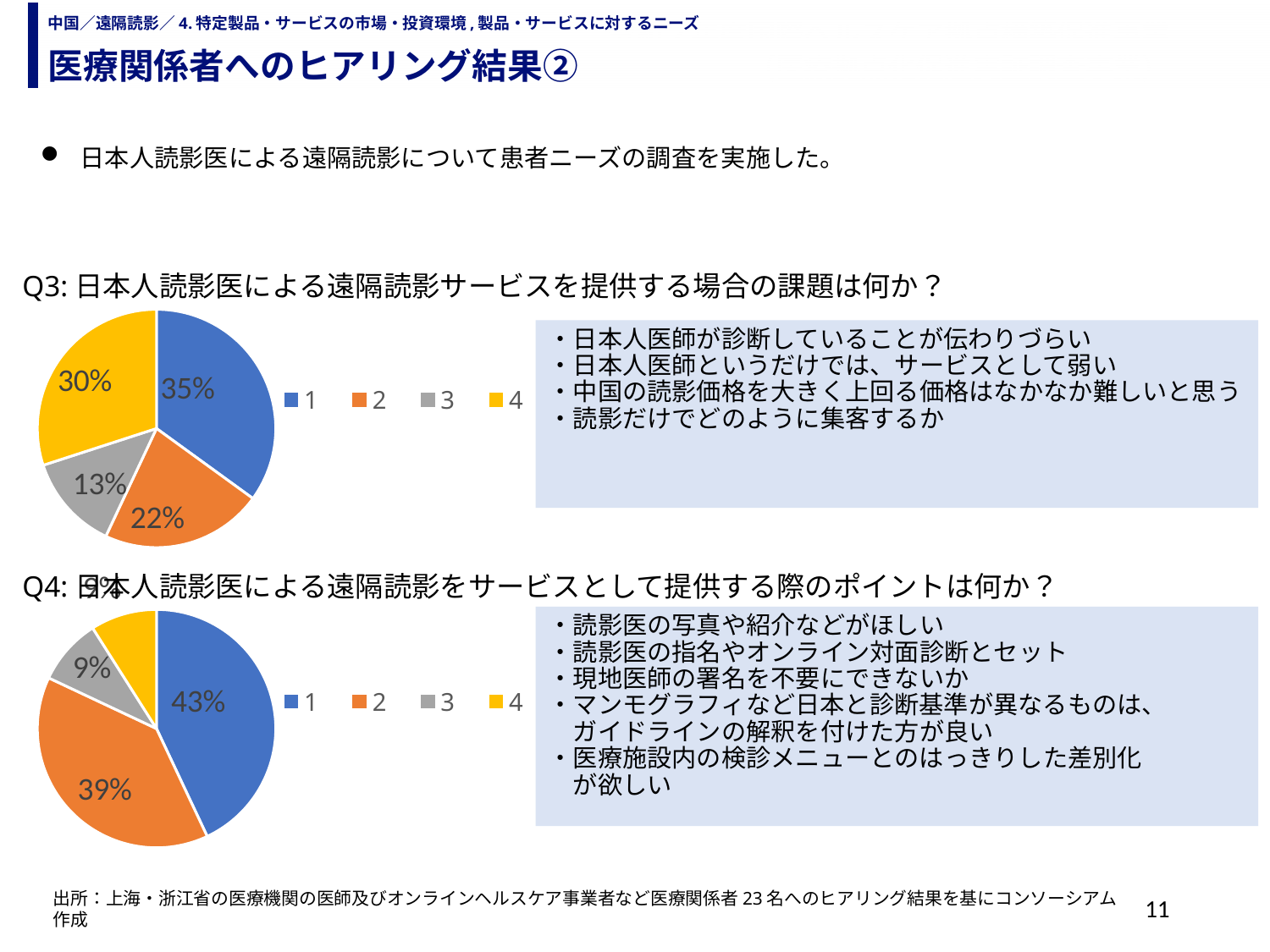
In the Q3 pie chart, what share does category 4 have? 30% In the Q3 pie chart, which category has the smallest share? 3 In the Q3 pie chart, which category has the largest share? 1 In the Q3 pie chart, what share does category 3 have? 13% In the Q4 pie chart, which is larger, category 1 or category 2? 1 In the Q4 pie chart, what share does category 1 have? 43% In the Q3 pie chart, what share does category 1 have? 35% In the Q4 pie chart, what is the difference in percentage points between category 1 and category 3? 34 In the Q3 pie chart, what is the difference in percentage points between category 1 and category 2? 13 How many entries does the legend of the Q3 pie chart list? 4 What type of chart is used for Q4? Pie chart In the Q4 pie chart, what share does category 2 have? 39%